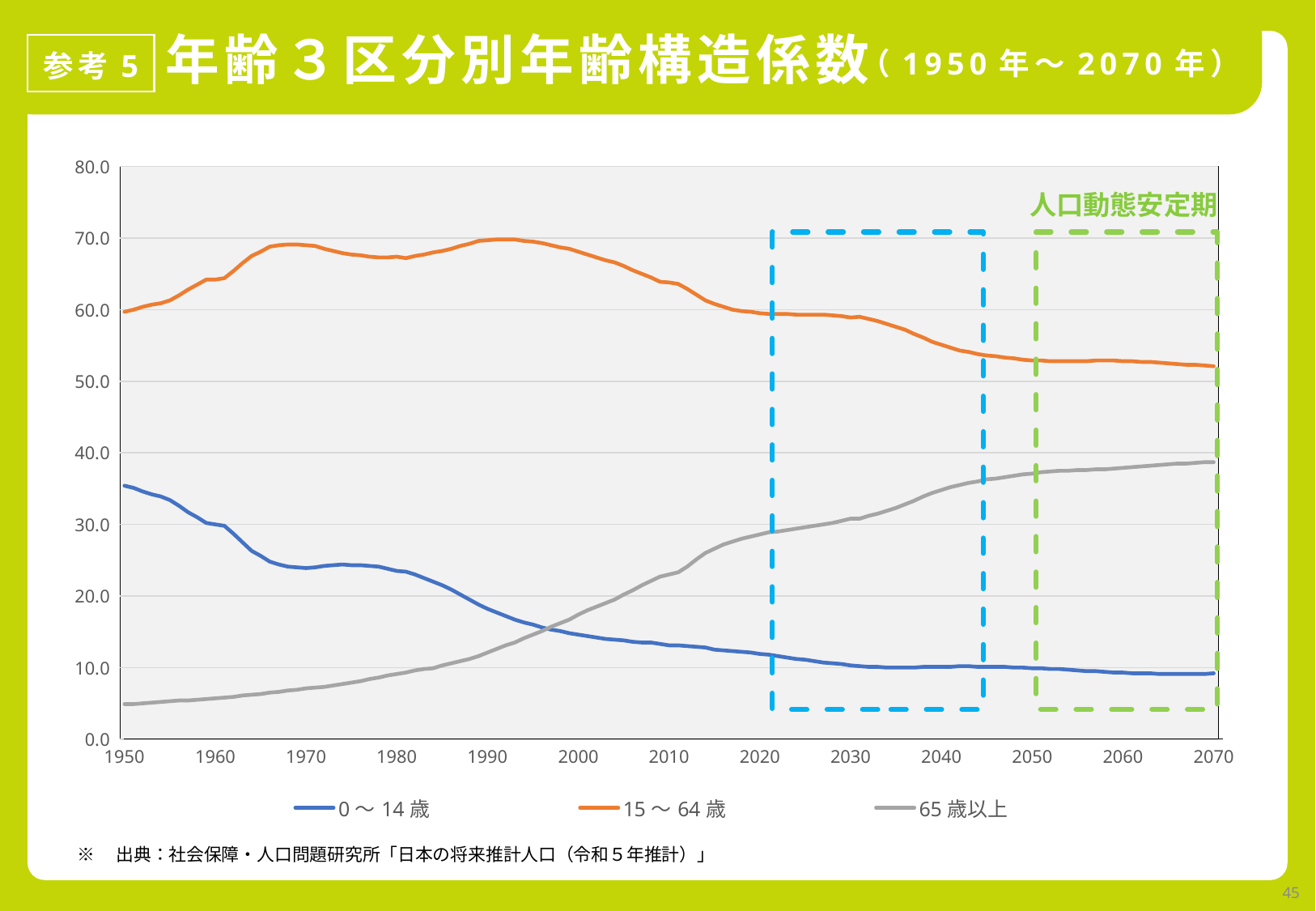
What kind of chart is shown on the slide? line chart Which series has the highest value in 2020? 15～64歳 What label is written above the green dashed box on the chart? 人口動態安定期 Does the value for 0～14歳 rise or fall from 1950 to 2070? fall Which series has the lowest value in 1950? 65歳以上 Does the value for 65歳以上 rise or fall from 1950 to 2070? rise In 2070, which is larger: the value for 65歳以上 or the value for 0～14歳? 65歳以上 How many series does the legend list? 3 Is the value for 65歳以上 in 2070 greater or less than 30.0? greater Is the value for 0～14歳 in 1950 greater or less than 30.0? greater Is the value for 15～64歳 in 1990 greater or less than 60.0? greater In 1950, which is larger: the value for 0～14歳 or the value for 65歳以上? 0～14歳